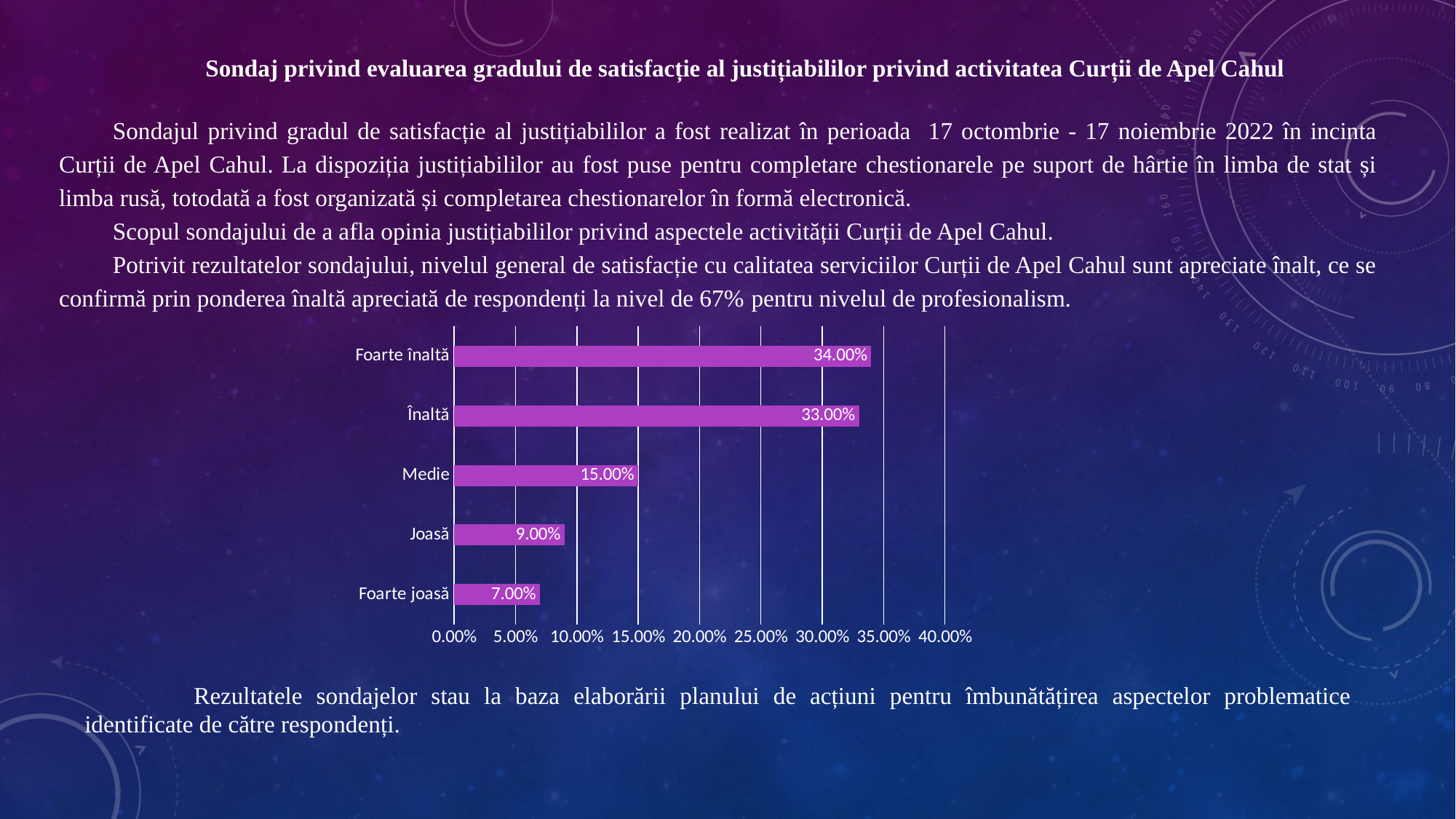
What kind of chart is shown on the slide? Bar chart What is the difference between the values for Foarte înaltă and Medie? 19.00% Which category has the lowest value? Foarte joasă What is the difference between the values for Joasă and Foarte joasă? 2.00% Which is larger, the value for Medie or the value for Joasă? Medie What is the value for Foarte înaltă? 34.00% What is the value for Înaltă? 33.00% What is the highest value shown on the x axis of the chart? 40.00% How many categories are shown in the chart? 5 What is the value for Joasă? 9.00% What is the value for Foarte joasă? 7.00% What is the value for Medie? 15.00%